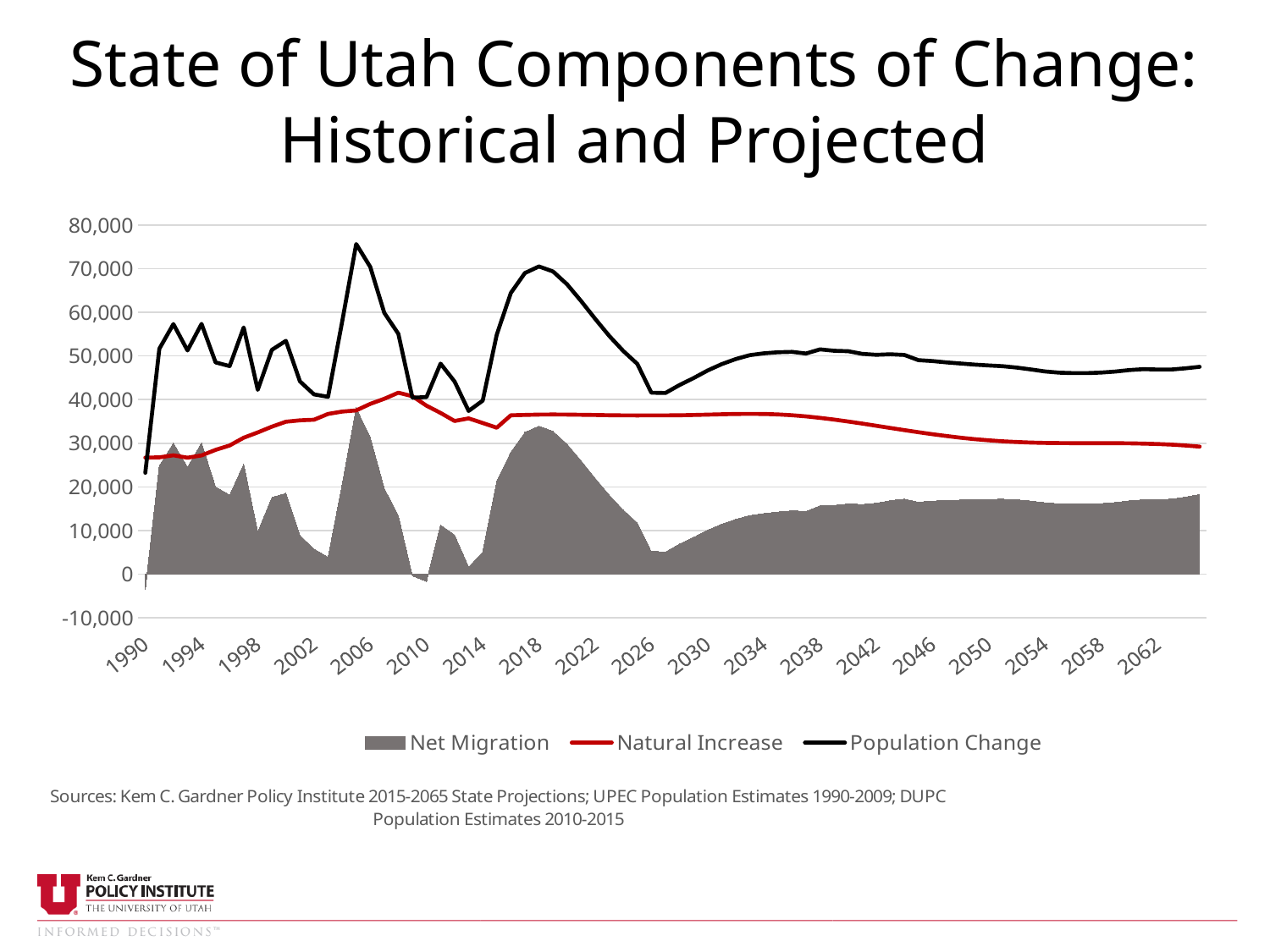
How many series does the legend list? 3 What colour is the Natural Increase line? Red Does Natural Increase rise or fall between 2034 and 2062? fall Is the value for Net Migration in 2018 greater or less than 30,000? greater In 2010, which is larger: Natural Increase or Net Migration? Natural Increase Which series reaches the highest value anywhere on the chart? Population Change What kind of chart is this? A combination line and area chart Is the value for Population Change in 2062 greater or less than 50,000? less In 2062, which is larger: Population Change or Natural Increase? Population Change